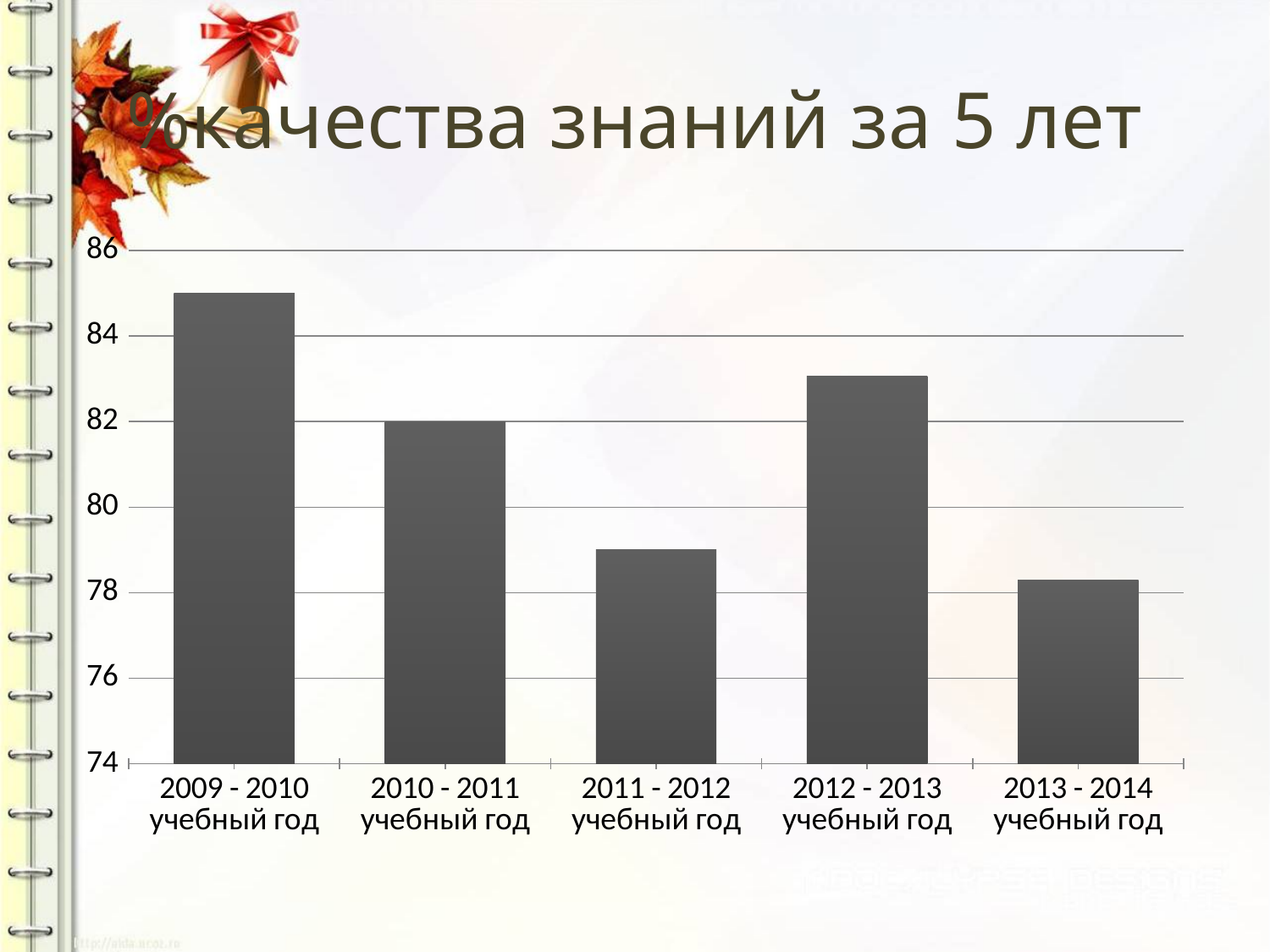
What is the value for 2010 - 2011 учебный год? 82 Is the value for 2012 - 2013 учебный год greater or less than 82? greater Is the value for 2013 - 2014 учебный год greater or less than 80? less What kind of chart is shown on the slide? bar chart How many academic years (categories) are plotted on the chart? 5 Which is larger, the value for 2010 - 2011 учебный год or for 2011 - 2012 учебный год? 2010 - 2011 учебный год Is the value for 2011 - 2012 учебный год greater or less than 80? less Which is larger, the value for 2009 - 2010 учебный год or for 2012 - 2013 учебный год? 2009 - 2010 учебный год What is the title of the chart? %качества знаний за 5 лет Which academic year has the highest value? 2009 - 2010 учебный год Does the value rise or fall from 2009 - 2010 учебный год to 2011 - 2012 учебный год? fall